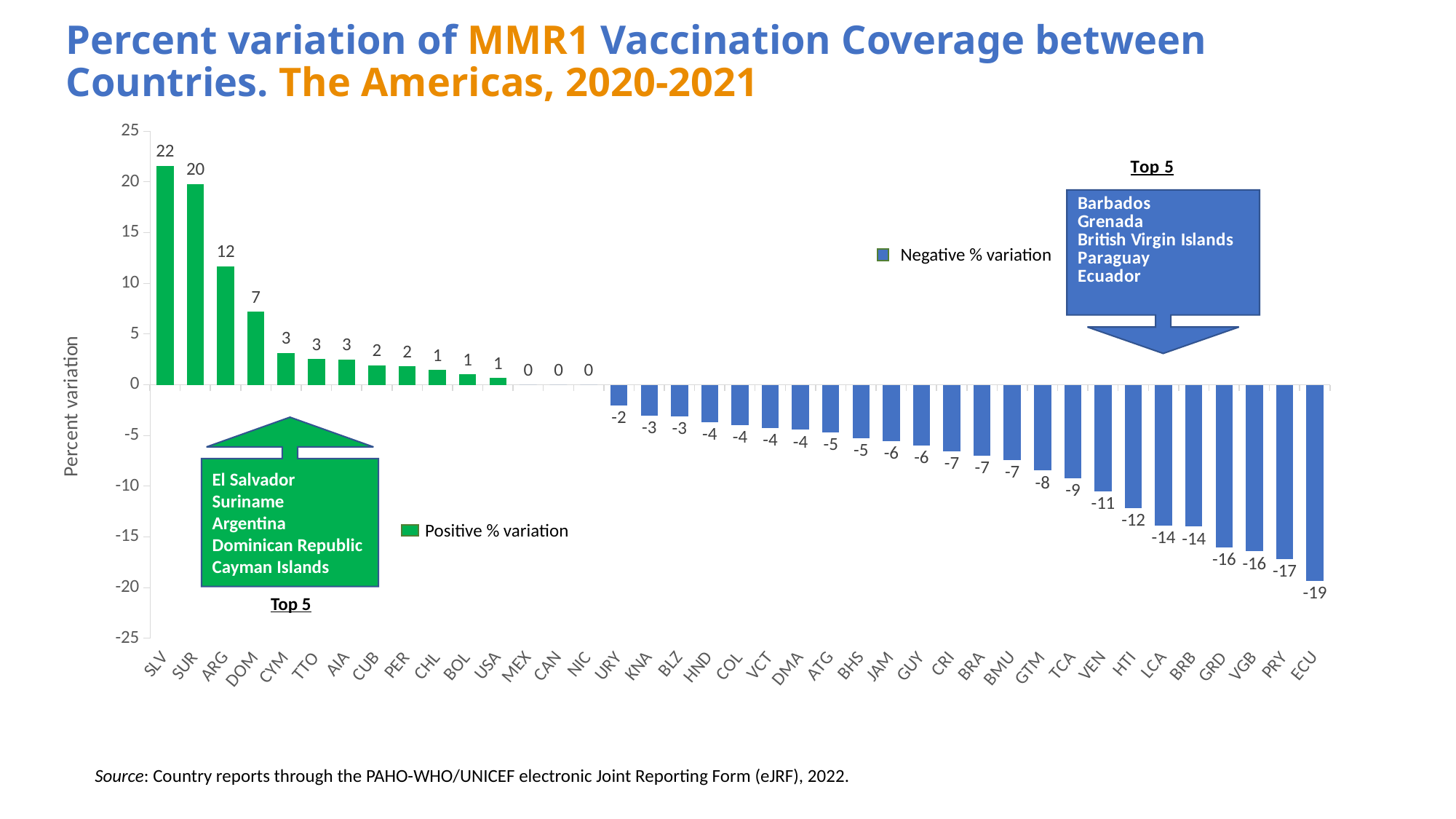
How many series does the legend list? 2 What is the percent variation for SLV? 22 What is the percent variation for GTM? -8 Which has a larger percent variation, ARG or DOM? ARG Which country has the lowest percent variation? ECU What is the percent variation for DOM? 7 What is the percent variation for ECU? -19 Which country has the highest percent variation? SLV Do the values rise or fall moving from left to right along the x axis? fall What kind of chart is shown on the slide? bar chart How many countries are shown on the x axis? 39 What is the difference between the percent variation for SLV and SUR? 2